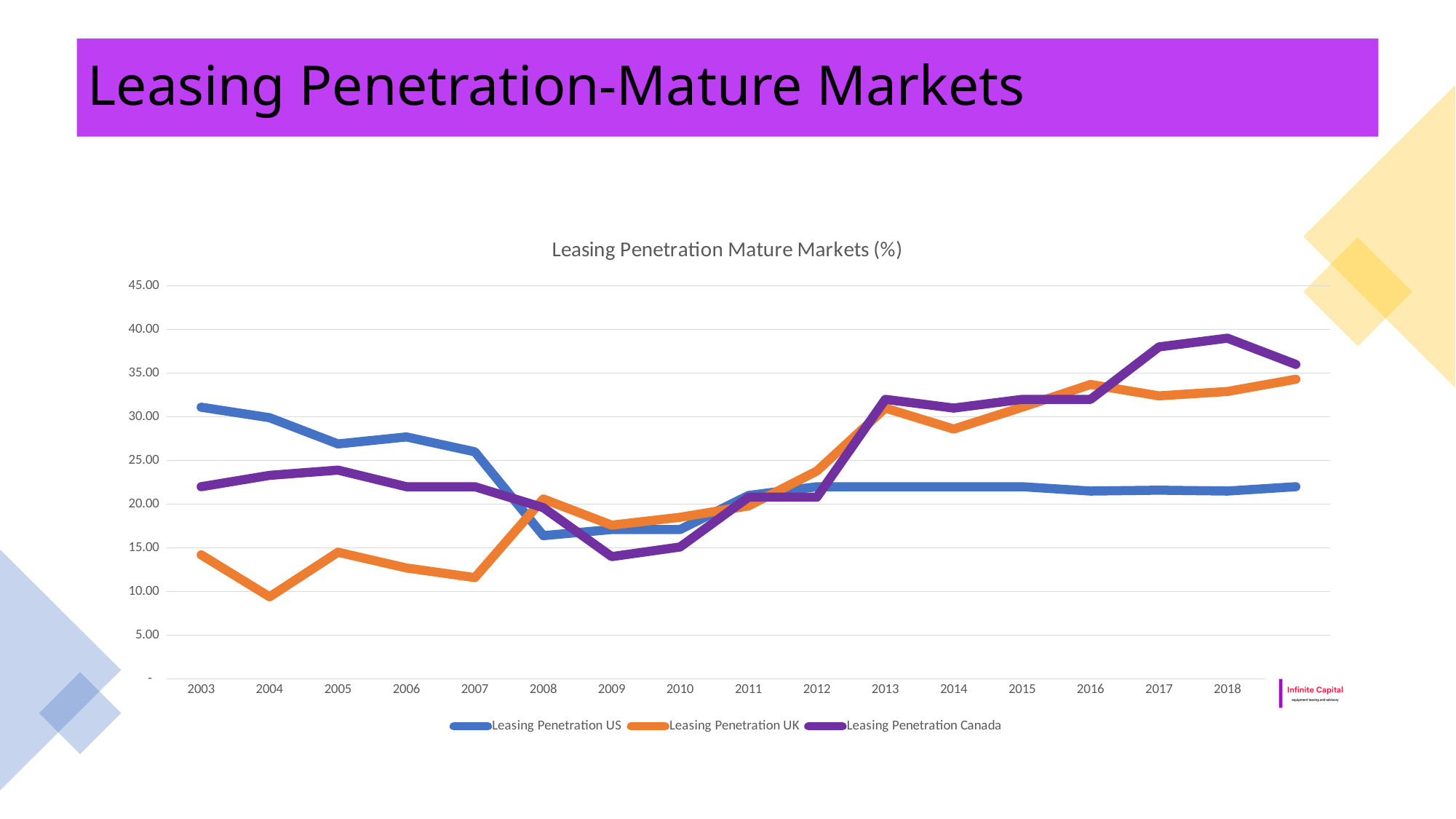
Is the value for Leasing Penetration UK in 2016 greater or less than 30.00? greater How many years are plotted along the x axis? 17 Does Leasing Penetration US rise or fall from 2003 to 2008? fall In which year is Leasing Penetration UK at its lowest? 2004 Is the value for Leasing Penetration UK in 2004 greater or less than 10.00? less How many series does the legend list? 3 What kind of chart is shown on the slide? line chart Is the value for Leasing Penetration US in 2003 greater or less than 30.00? greater In 2003, which is larger: Leasing Penetration US or Leasing Penetration UK? Leasing Penetration US In which year is Leasing Penetration Canada at its highest? 2018 In 2018, which is larger: Leasing Penetration Canada or Leasing Penetration US? Leasing Penetration Canada